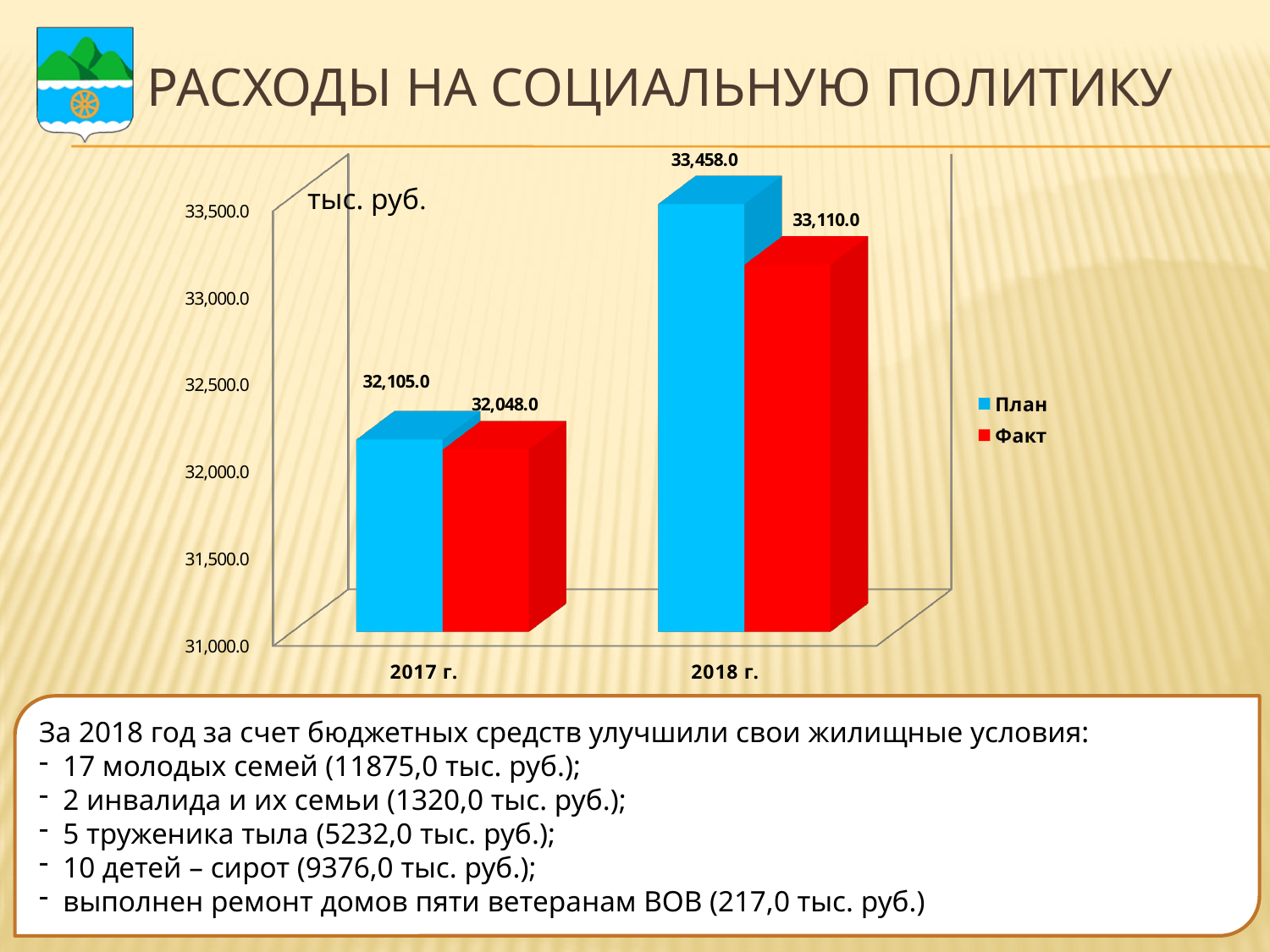
What is the План value for 2018 г.? 33,458.0 What is the Факт value for 2017 г.? 32,048.0 What unit is indicated on the chart? тыс. руб. What is the План value for 2017 г.? 32,105.0 Which is larger for 2017 г., План or Факт? План What is the difference between the План values for 2018 г. and 2017 г.? 1,353.0 What is the difference between План and Факт for 2018 г.? 348.0 How many series does the legend list? 2 Which year has the lowest План value? 2017 г. What kind of chart is shown on the slide? Bar chart What is the Факт value for 2018 г.? 33,110.0 Which year has the highest Факт value? 2018 г.